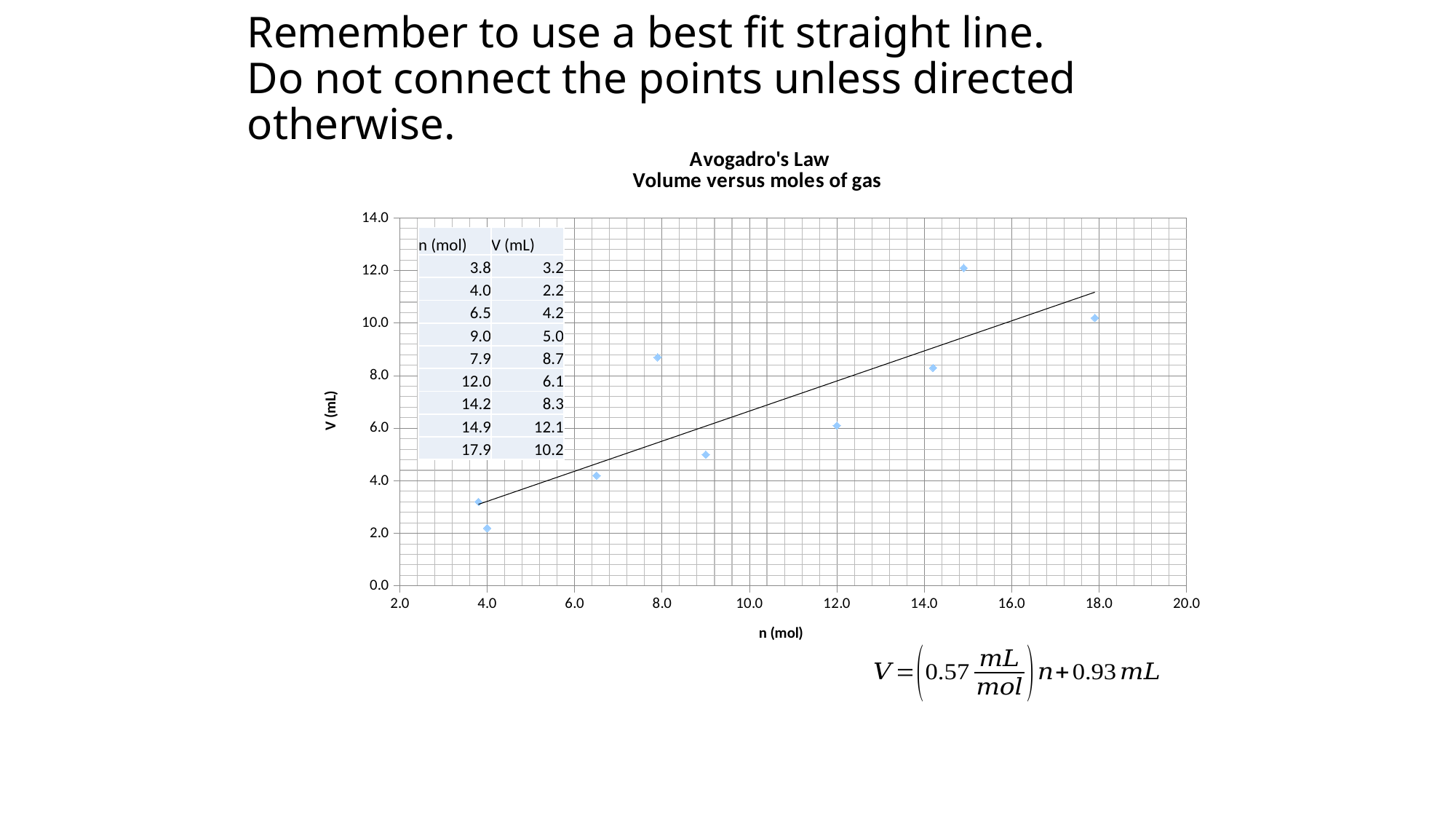
What is the difference in volume between n = 14.9 mol and n = 14.2 mol? 3.8 At which value of n (mol) is the volume highest? 14.9 What is the lowest volume value in the data? 2.2 Overall, does the volume rise or fall as n increases along the x axis? rises How many data points are plotted on the chart? 9 What is the title of the chart? Avogadro's Law Volume versus moles of gas What type of chart is shown on the slide? scatter chart What is the volume V (mL) when n is 17.9 mol? 10.2 What is the volume V (mL) when n is 7.9 mol? 8.7 Which has the larger volume: n = 9.0 mol or n = 7.9 mol? 7.9 mol What is the volume V (mL) when n is 12.0 mol? 6.1 What is the label of the y axis? V (mL)